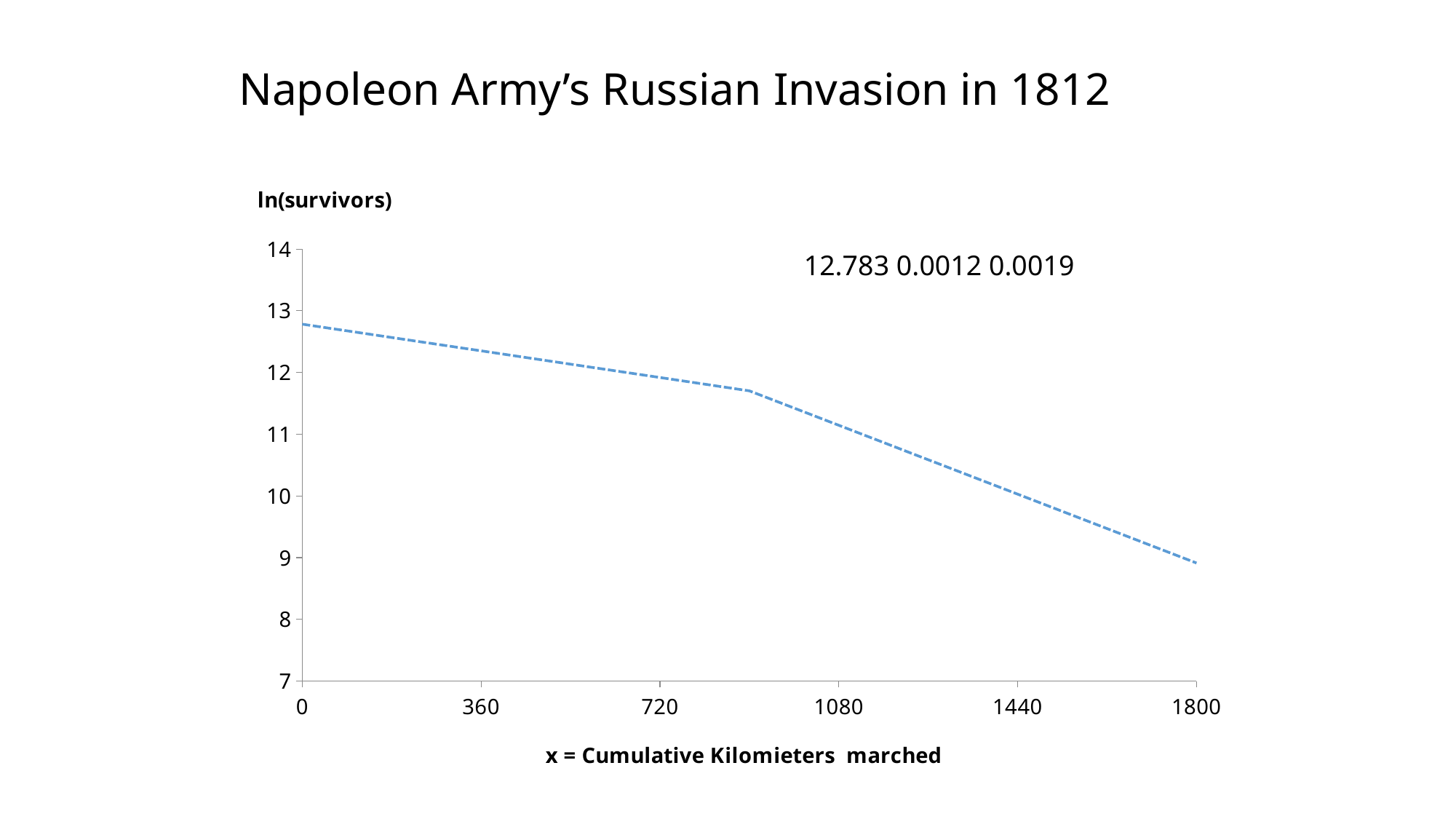
What is the title of the chart on the slide? Napoleon Army's Russian Invasion in 1812 Is the value of ln(survivors) at 0 kilometers marched greater or less than 13? less What is the label of the vertical axis? ln(survivors) What kind of chart is shown on the slide? line chart Is the value of ln(survivors) at 900 kilometers marched greater or less than 12? less Is the value of ln(survivors) at 1800 kilometers marched greater or less than 8? greater Do the values of ln(survivors) rise or fall as cumulative kilometers marched increases? fall Which has the larger ln(survivors) value, 0 kilometers marched or 1800 kilometers marched? 0 kilometers marched